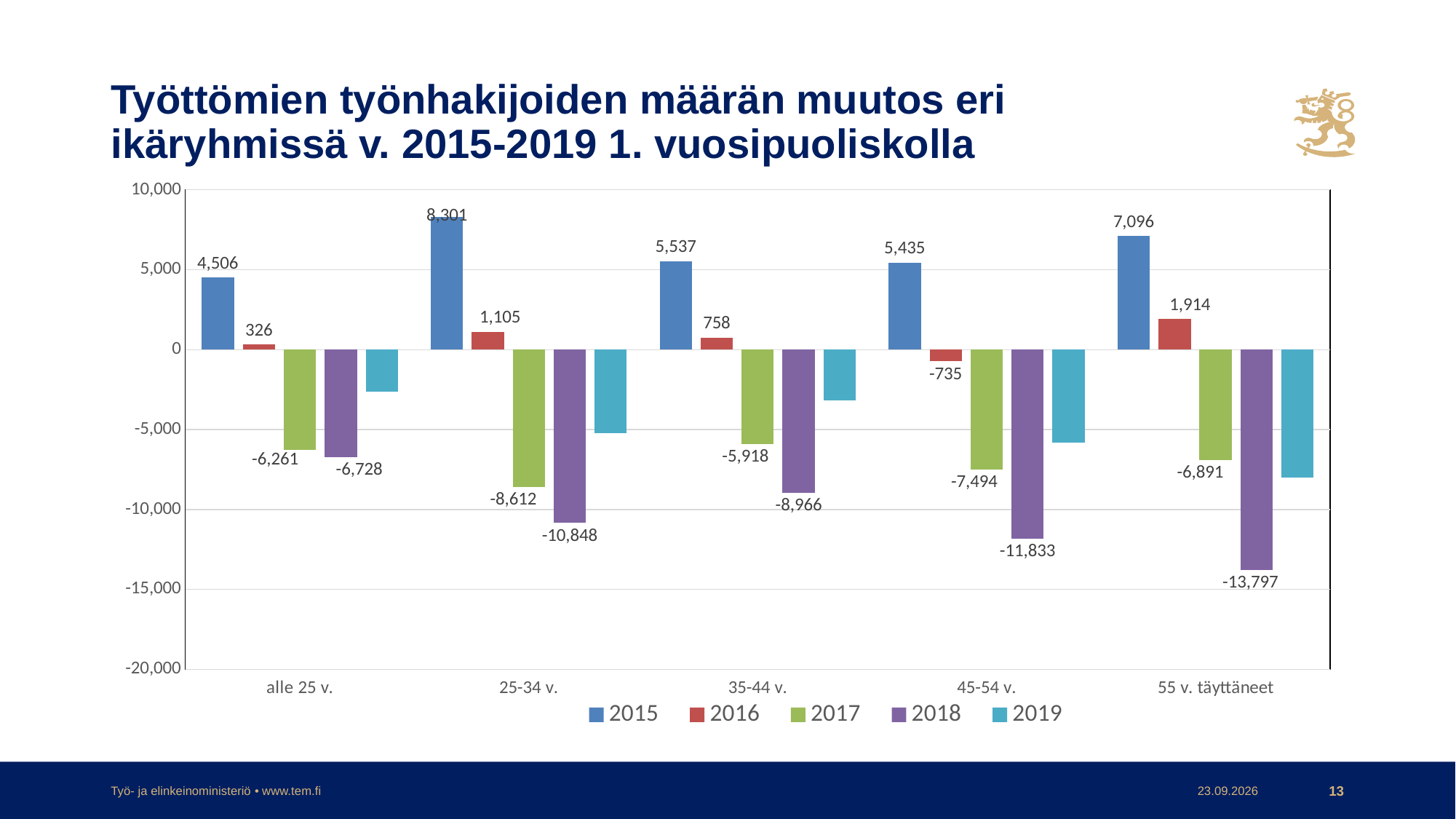
How many age groups are shown on the x axis? 5 Which age group has the highest value for the 2015 series? 25-34 v. Which is larger, the 2017 value for 25-34 v. or the 2017 value for 35-44 v.? 35-44 v. Is the value for 2019 in the alle 25 v. age group greater or less than -5,000? greater Is the value for 2019 in the 55 v. täyttäneet age group greater or less than -5,000? less Which age group has the lowest value for the 2018 series? 55 v. täyttäneet How many series does the legend list? 5 What is the difference between the 2015 value and the 2016 value in the alle 25 v. age group? 4,180 What is the value for 2018 in the 55 v. täyttäneet age group? -13,797 What is the value for 2015 in the 25-34 v. age group? 8,301 What kind of chart is shown on the slide? Bar chart What is the value for 2016 in the 45-54 v. age group? -735